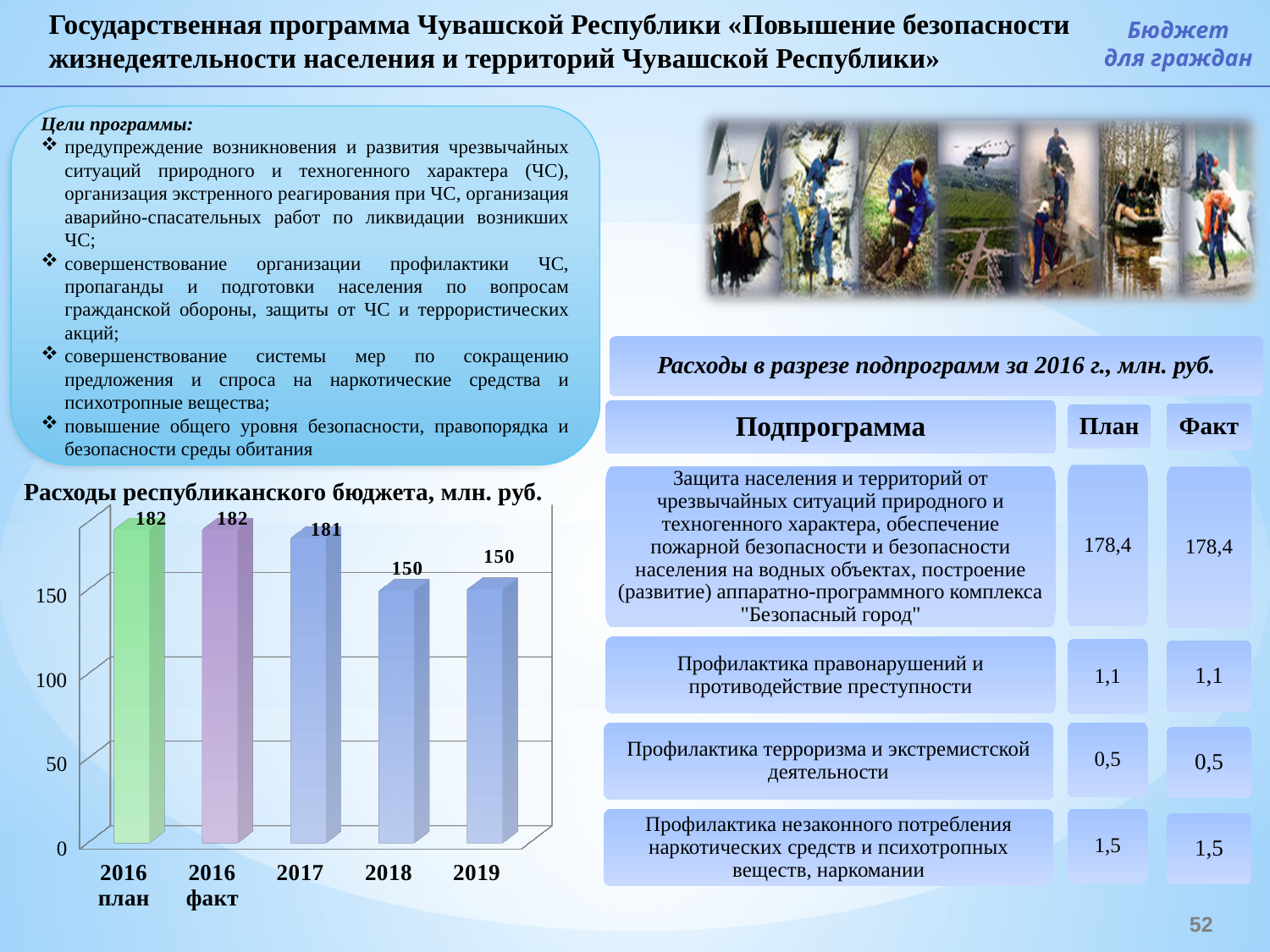
What is the difference between the values for 2016 план and 2017 in the chart? 1 Which category has the lowest value in the chart, 2017 or 2018? 2018 Which is larger in the chart, the value for 2017 or the value for 2019? 2017 What is the value for 2017 in the chart "Расходы республиканского бюджета, млн. руб."? 181 Do the values in the chart rise or fall from 2016 план to 2019? fall How many categories are shown on the x axis of the chart? 5 Is the value for 2018 greater or less than 100 in the chart? greater What is the difference between the values for 2017 and 2018 in the chart? 31 What is the value for 2016 план in the chart? 182 What is the value for 2019 in the chart? 150 What kind of chart is shown on the slide? bar chart What is the value for 2016 факт in the chart? 182